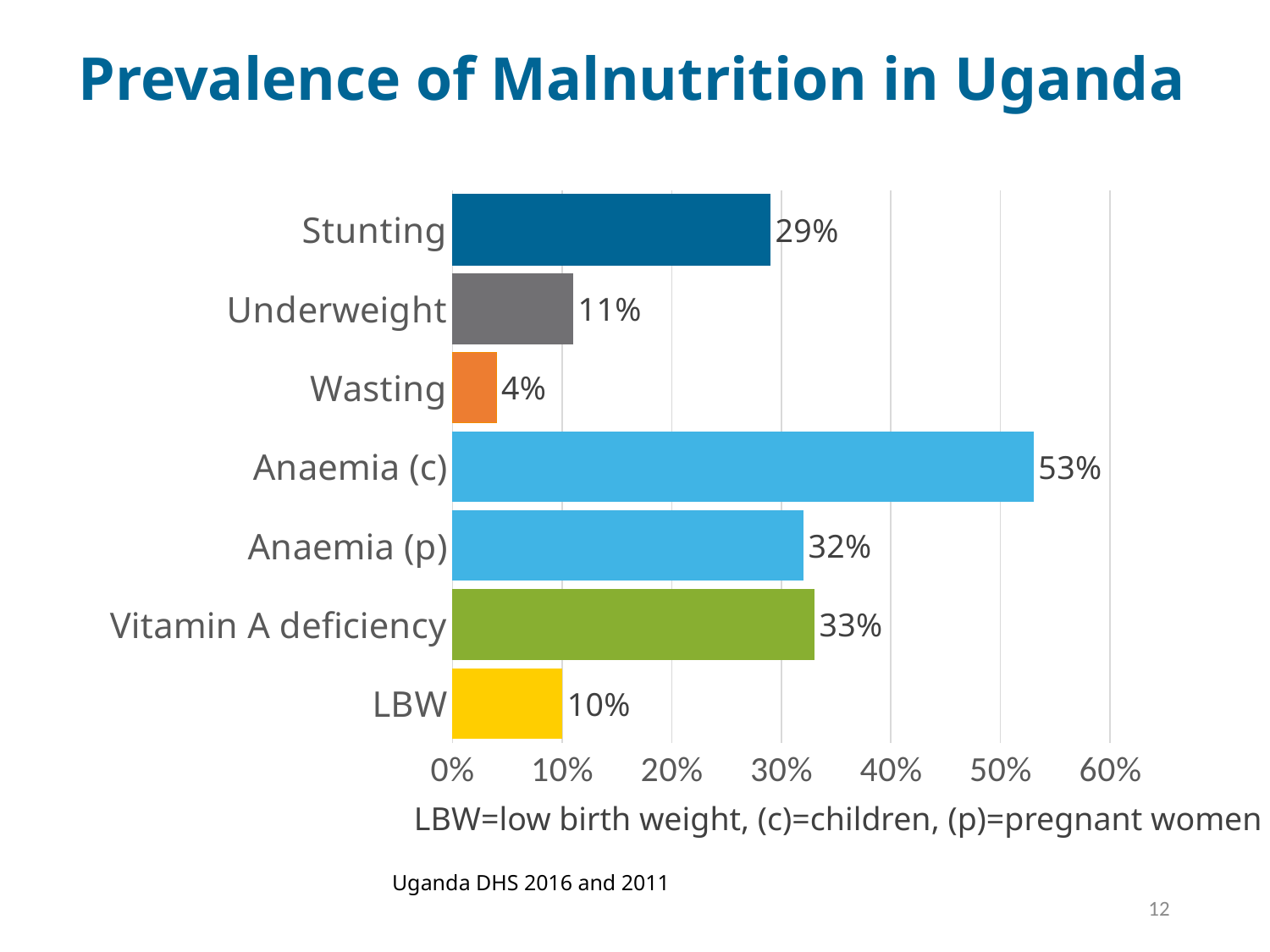
How many categories are shown on the chart? 7 What is the value for LBW? 10% What kind of chart is shown on the slide? bar chart What is the difference between the values for Stunting and Underweight? 18% What is the title of the slide? Prevalence of Malnutrition in Uganda What is the prevalence of Stunting shown on the chart? 29% Which is larger, the value for Stunting or the value for Anaemia (p)? Anaemia (p) What is the value for Anaemia (c)? 53% Which category has the lowest prevalence? Wasting Which category has the highest prevalence? Anaemia (c) Is the value for Vitamin A deficiency greater or less than 30%? greater What is the difference between the values for Anaemia (c) and Anaemia (p)? 21%